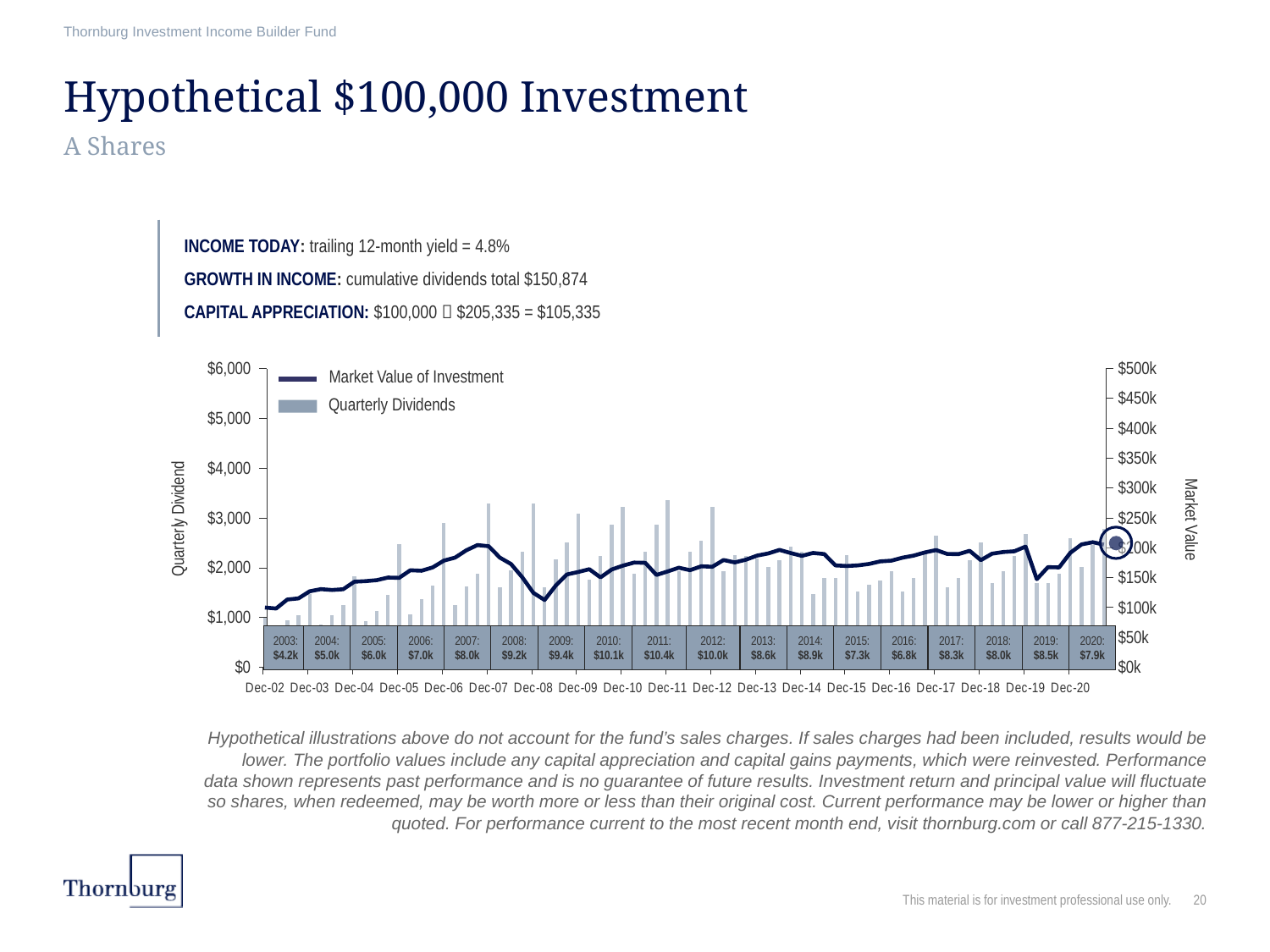
Which year has the highest annual dividend total printed on the chart? 2011 Do the annual dividend totals rise or fall from 2003 to 2011? rise How many years have annual dividend totals printed on the chart? 18 What is the annual dividend total shown for 2003? $4.2k What is the difference between the annual dividend totals for 2011 and 2003? $6.2k What is the annual dividend total shown for 2020? $7.9k Is the Market Value of Investment at Dec-08 greater or less than $150k? less How many series does the legend list? 2 What kind of chart is shown? Combined bar and line chart Which year has a larger annual dividend total, 2014 or 2015? 2014 Which year has the lowest annual dividend total printed on the chart? 2003 What is the annual dividend total shown for 2011? $10.4k